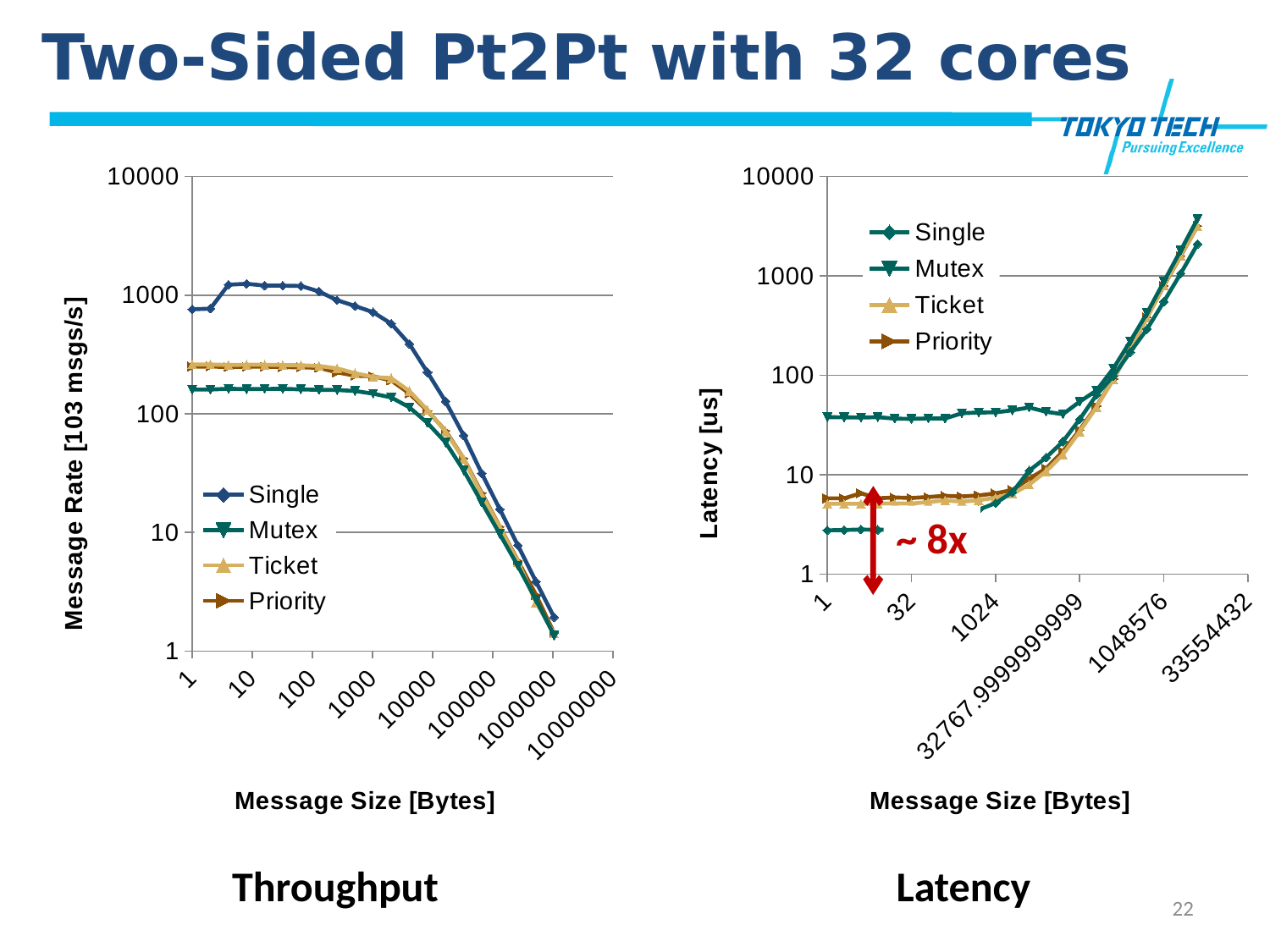
In the Latency chart, do the latency values rise or fall as message size increases toward 33554432 bytes? Rise In the Throughput chart, how many series does the legend list? 4 In the Latency chart, which series has higher latency at message size 1, Mutex or Single? Mutex In the Throughput chart, is the message rate for Single at message size 1 greater or less than 100? greater In the Latency chart, is the latency for Single at message size 1 greater or less than 10? less In the Latency chart, how many series does the legend list? 4 What kind of chart is the Throughput chart? Line chart In the Latency chart, is the latency for Mutex at message size 1 greater or less than 10? greater In the Throughput chart, do the message rate values rise or fall as message size increases toward 1000000 bytes? Fall In the Throughput chart, which series has the highest message rate at message size 10? Single What is the y-axis title of the Latency chart? Latency [us]